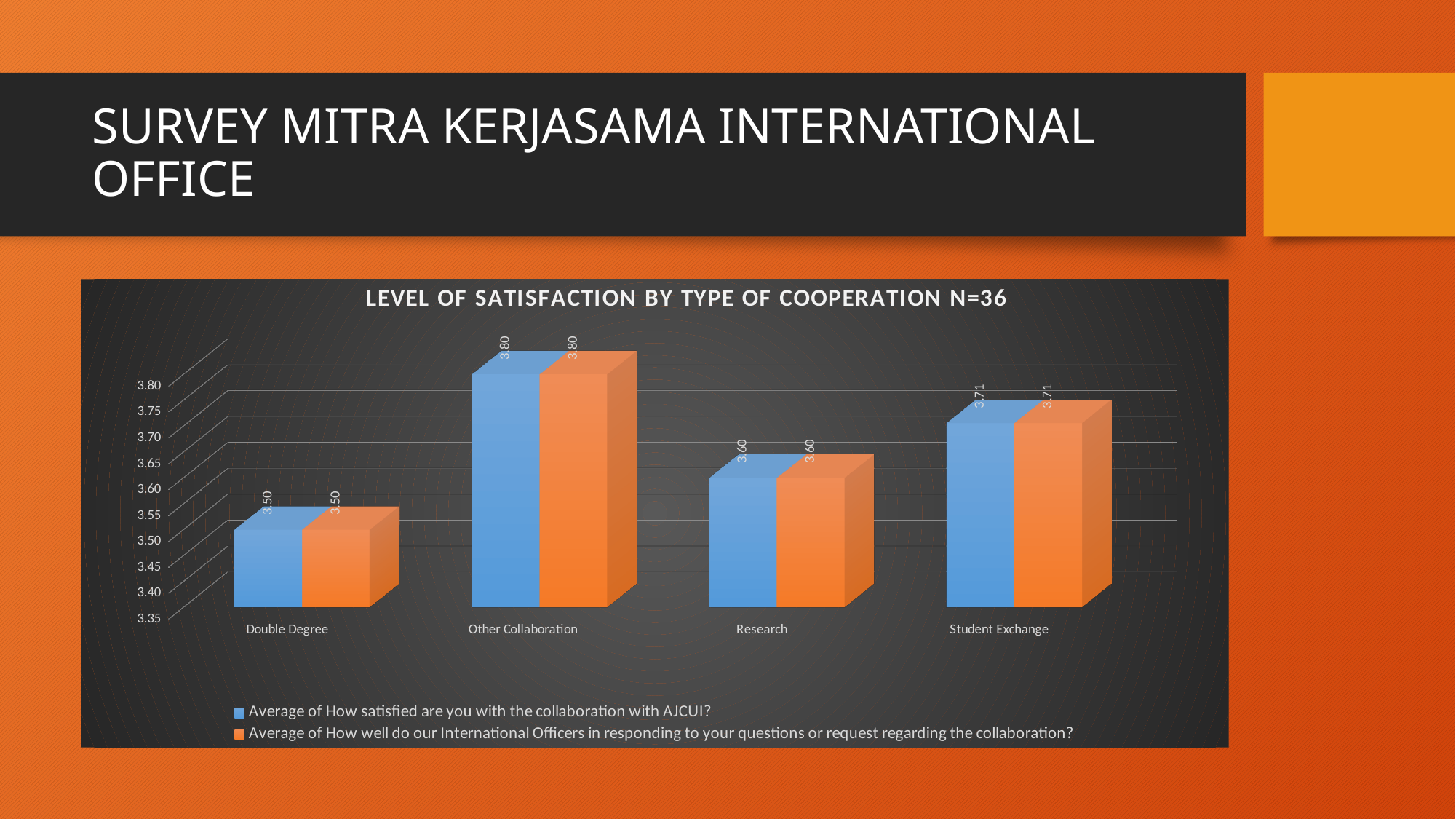
Which type of cooperation has the highest satisfaction value? Other Collaboration What is the value for Student Exchange in the series 'Average of How well do our International Officers in responding to your questions or request regarding the collaboration?'? 3.71 How many types of cooperation are shown on the x axis? 4 What kind of chart is shown on the slide? Bar chart What is the value for Research in the series 'Average of How satisfied are you with the collaboration with AJCUI?'? 3.60 What is the title of the chart? LEVEL OF SATISFACTION BY TYPE OF COOPERATION N=36 What is the value for Double Degree in the series 'Average of How satisfied are you with the collaboration with AJCUI?'? 3.50 Which is larger: the Student Exchange value or the Research value in the series 'Average of How satisfied are you with the collaboration with AJCUI?'? Student Exchange How many series does the legend list? 2 What is the value for Other Collaboration in the series 'Average of How well do our International Officers in responding to your questions or request regarding the collaboration?'? 3.80 Which type of cooperation has the lowest satisfaction value? Double Degree What is the difference between the Other Collaboration and Double Degree values in the series 'Average of How satisfied are you with the collaboration with AJCUI?'? 0.30